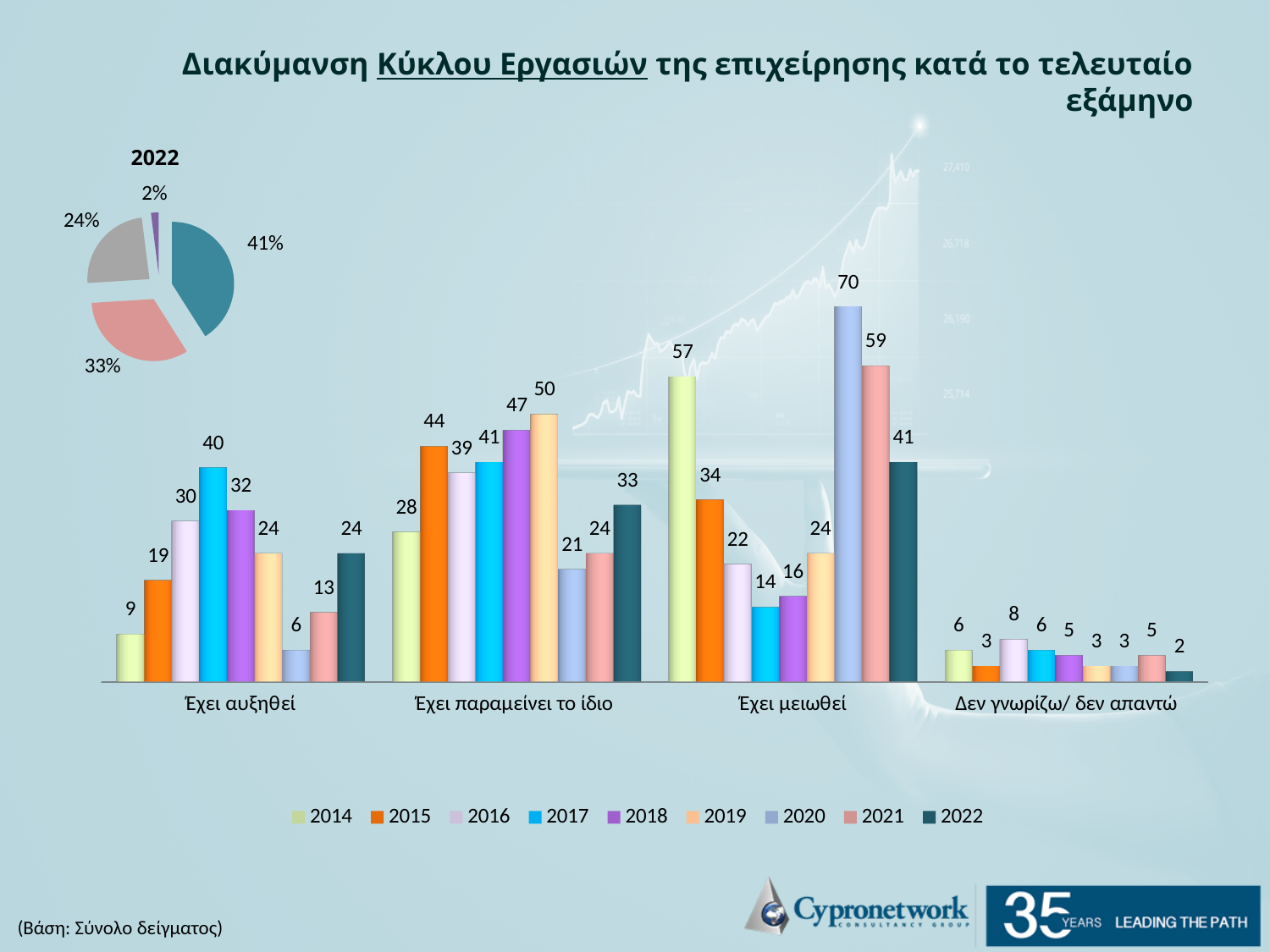
In the bar chart, what is the value for 2019 in the 'Έχει παραμείνει το ίδιο' category? 50 In the bar chart, what is the value for 2014 in the 'Έχει αυξηθεί' category? 9 In the bar chart, which year has the lowest value in the 'Έχει αυξηθεί' category? 2020 What kind of chart is the small chart in the top left of the slide? Pie chart In the bar chart, what is the value for 2022 in the 'Έχει μειωθεί' category? 41 In the bar chart, which year has the highest value in the 'Έχει μειωθεί' category? 2020 How many categories are shown on the x axis of the bar chart? 4 In the bar chart, which is larger in the 'Έχει παραμείνει το ίδιο' category: the value for 2015 or the value for 2016? 2015 In the pie chart labelled 2022, what is the share of the smallest slice? 2% In the pie chart labelled 2022, what is the share of the largest slice? 41% In the bar chart, what is the difference between the 2020 and 2021 values in the 'Έχει μειωθεί' category? 11 How many series does the legend of the bar chart list? 9